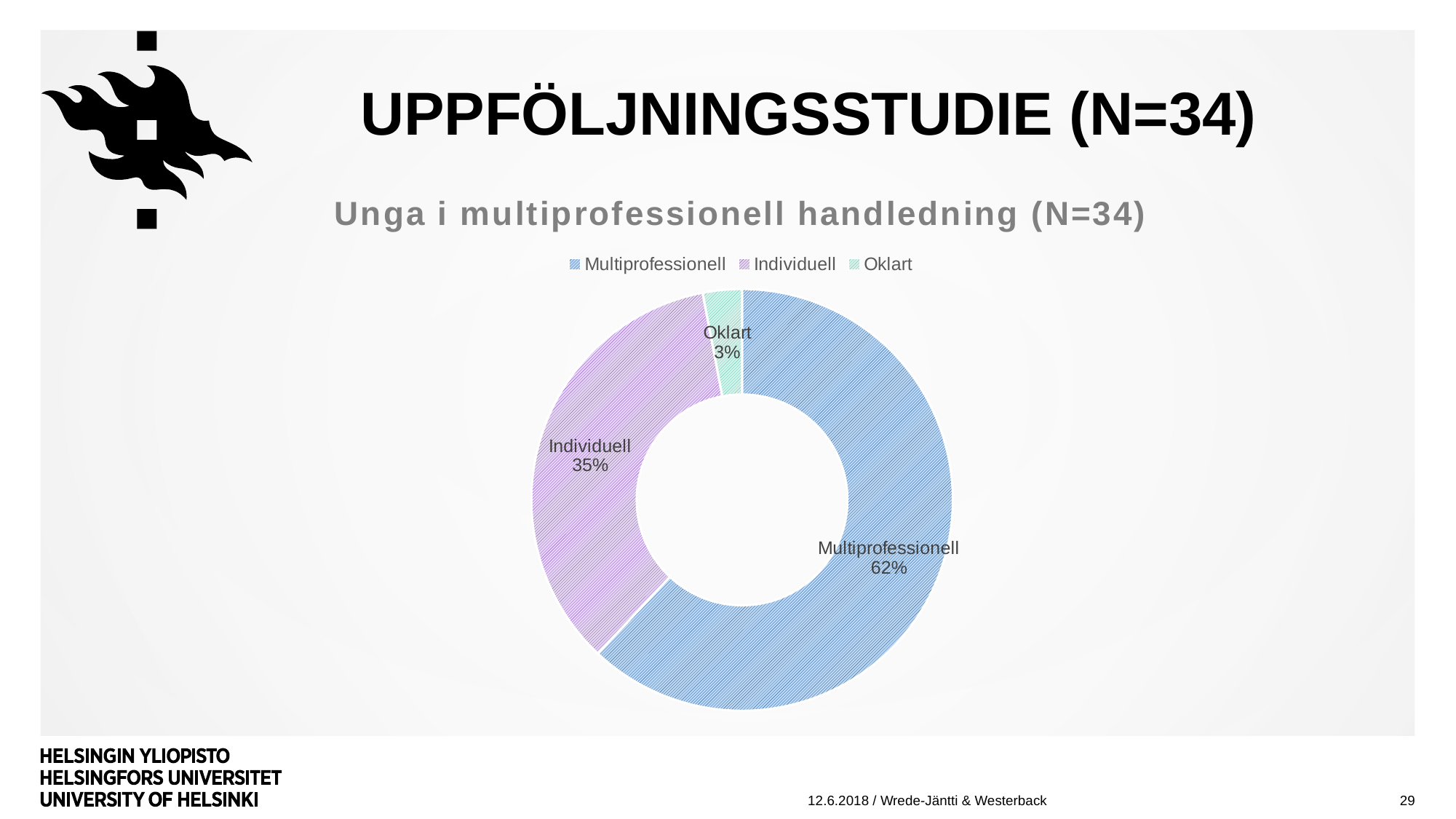
What share of the chart does Individuell account for? 35% What share of the chart does Oklart account for? 3% What is the difference in percentage points between Multiprofessionell and Individuell? 27 What share of the chart does Multiprofessionell account for? 62% Which category has the smallest share of the chart? Oklart What is the difference in percentage points between Individuell and Oklart? 32 How many entries does the chart legend list? 3 Which category has the largest share of the chart? Multiprofessionell What is the title of the chart? Unga i multiprofessionell handledning (N=34) What kind of chart is shown on the slide? Doughnut chart Which is larger, the share for Individuell or the share for Oklart? Individuell How many categories are shown in the chart? 3